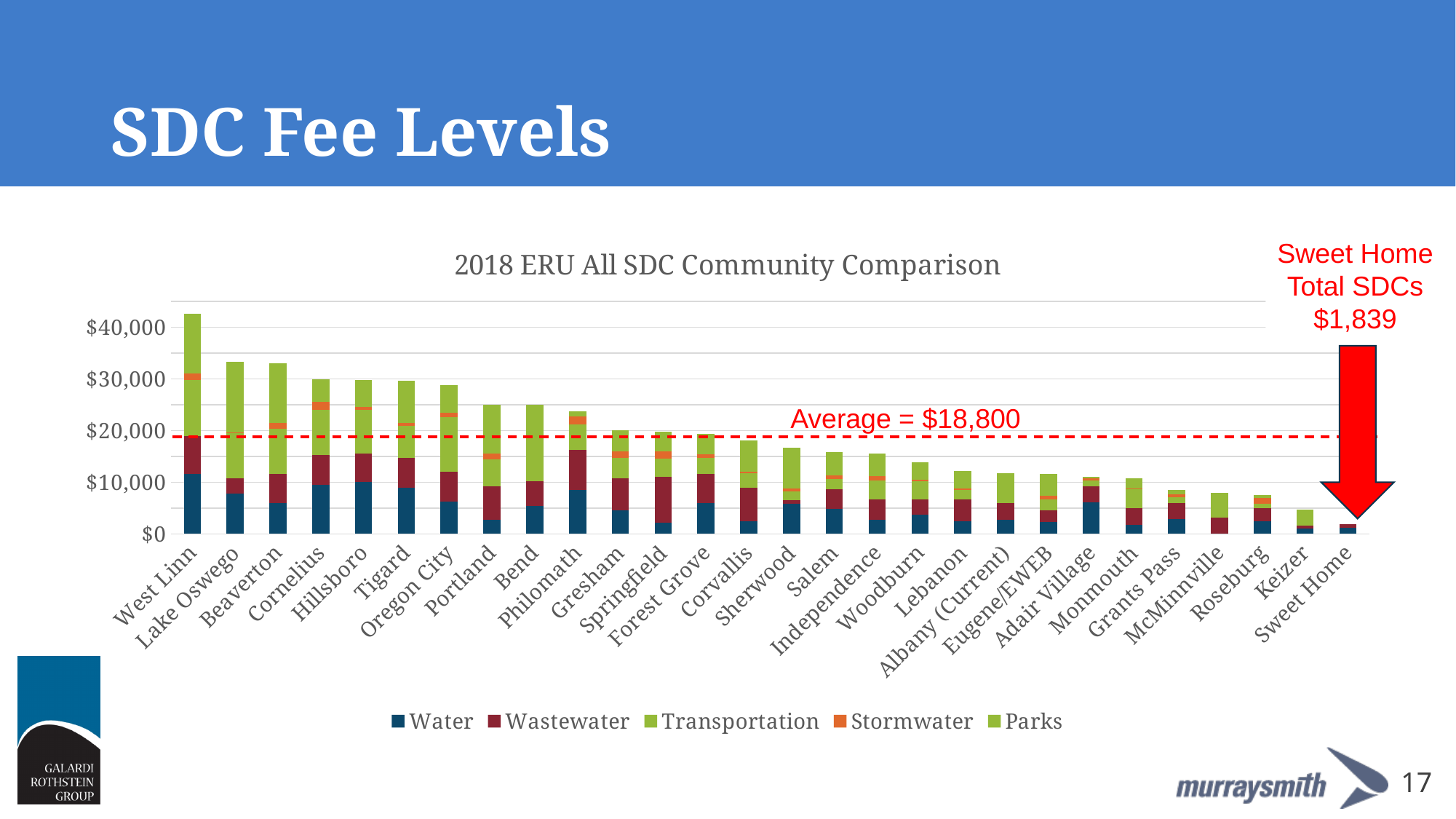
What is the total SDC value for Sweet Home as annotated on the slide? $1,839 Do the total bar heights generally rise or fall moving from left to right along the x axis? fall Which has a larger total SDC bar, West Linn or Lake Oswego? West Linn Is the total bar for West Linn greater or less than $40,000? greater What is the title of the chart? 2018 ERU All SDC Community Comparison How many communities are shown on the x axis of the chart? 28 Which community has the lowest total SDC bar? Sweet Home Which community has the highest total SDC bar? West Linn Is the total bar for Keizer greater or less than $10,000? less What type of chart is shown on the slide? Stacked bar chart What average value is marked by the dashed red line? $18,800 How many series does the legend list? 5